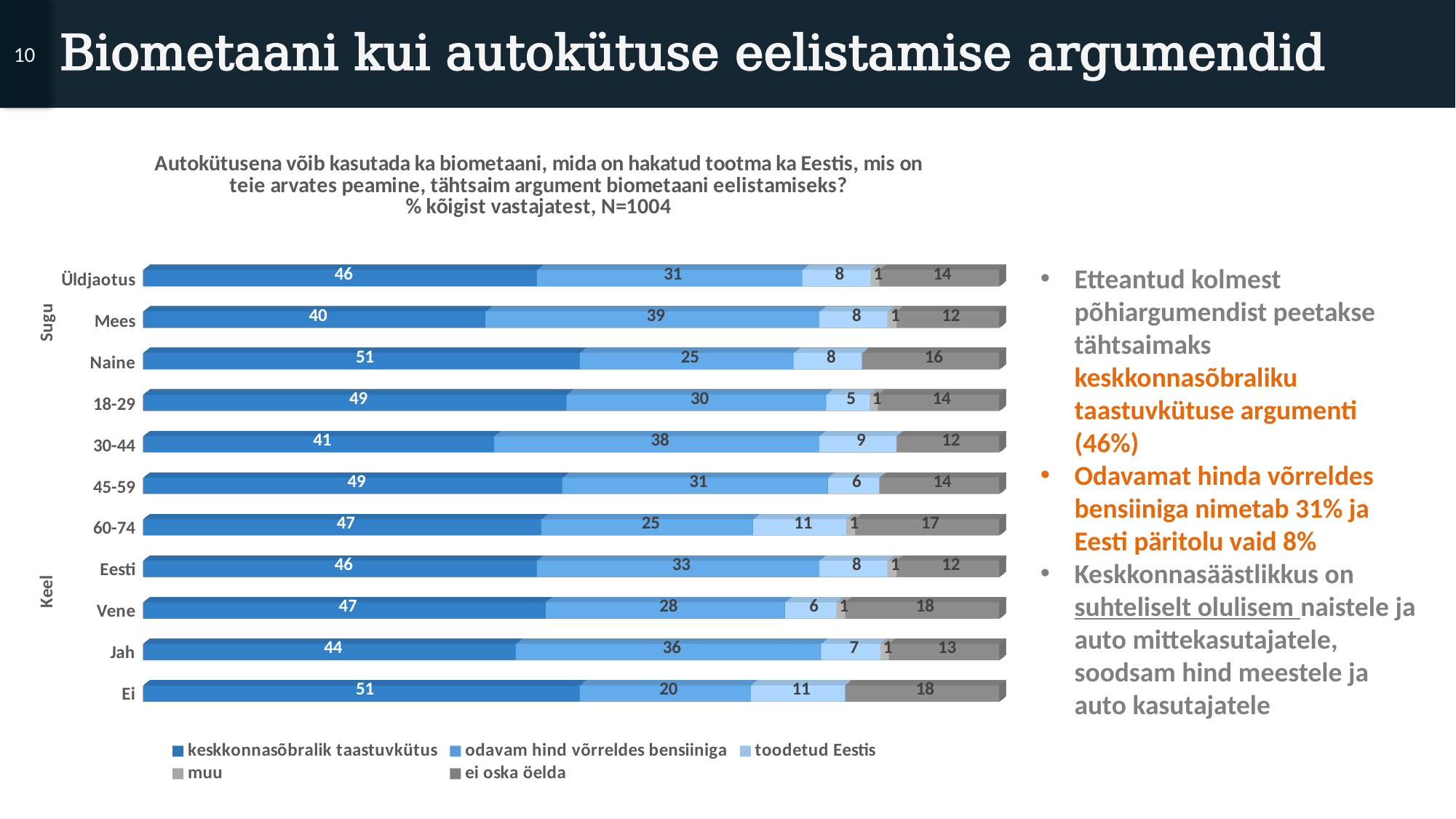
How many series does the legend list? 5 What is the total of the Üldjaotus stacked bar? 100 In the Üldjaotus bar, what is the difference between 'keskkonnasõbralik taastuvkütus' and 'odavam hind võrreldes bensiiniga'? 15 Which is larger: the 'keskkonnasõbralik taastuvkütus' value for Naine or for Mees? Naine What kind of chart is shown on the slide? Stacked bar chart Which category has the highest value for 'odavam hind võrreldes bensiiniga'? Mees What is the value for 'odavam hind võrreldes bensiiniga' in the Mees bar? 39 What is the value for 'toodetud Eestis' in the Ei bar? 11 How many categories (bars) are shown in the chart? 11 Which category has the lowest value for 'odavam hind võrreldes bensiiniga'? Ei What is the value for 'keskkonnasõbralik taastuvkütus' in the Üldjaotus bar? 46 What is the value for 'ei oska öelda' in the 60-74 bar? 17